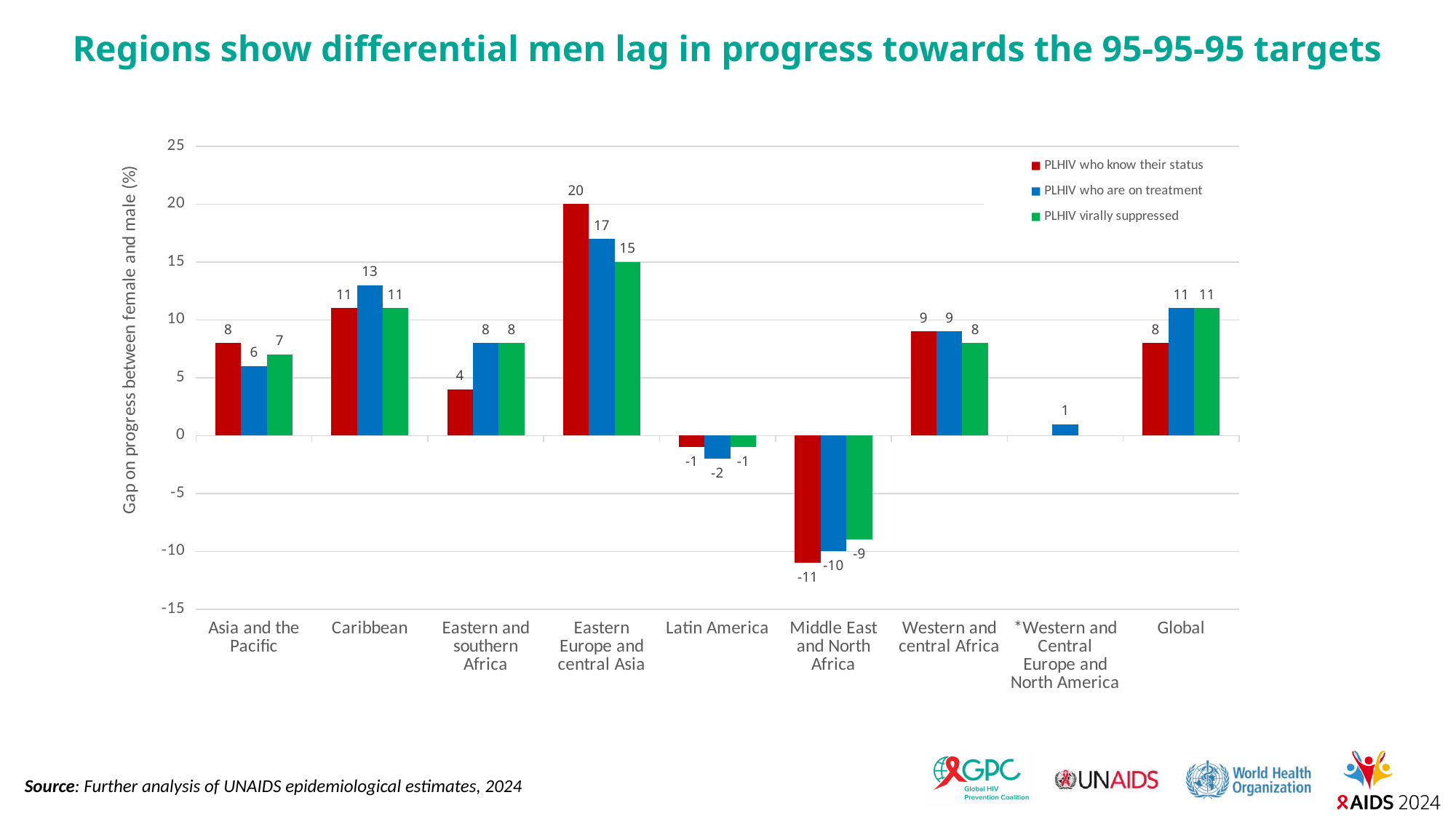
Which is larger in Eastern and southern Africa: the value for PLHIV who know their status or the value for PLHIV who are on treatment? PLHIV who are on treatment What is the value for PLHIV who know their status in Eastern Europe and central Asia? 20 What is the value for PLHIV who are on treatment in the Caribbean? 13 How many series does the legend list? 3 What is the value for PLHIV virally suppressed in Middle East and North Africa? -9 Which region has the highest value for PLHIV who know their status? Eastern Europe and central Asia How many regions are shown on the x axis? 9 What is the label of the y axis? Gap on progress between female and male (%) What kind of chart is shown on the slide? Bar chart What is the Global value for PLHIV who know their status? 8 What is the difference between the PLHIV who know their status value and the PLHIV virally suppressed value in Eastern Europe and central Asia? 5 Which region has the lowest value for PLHIV who are on treatment? Middle East and North Africa